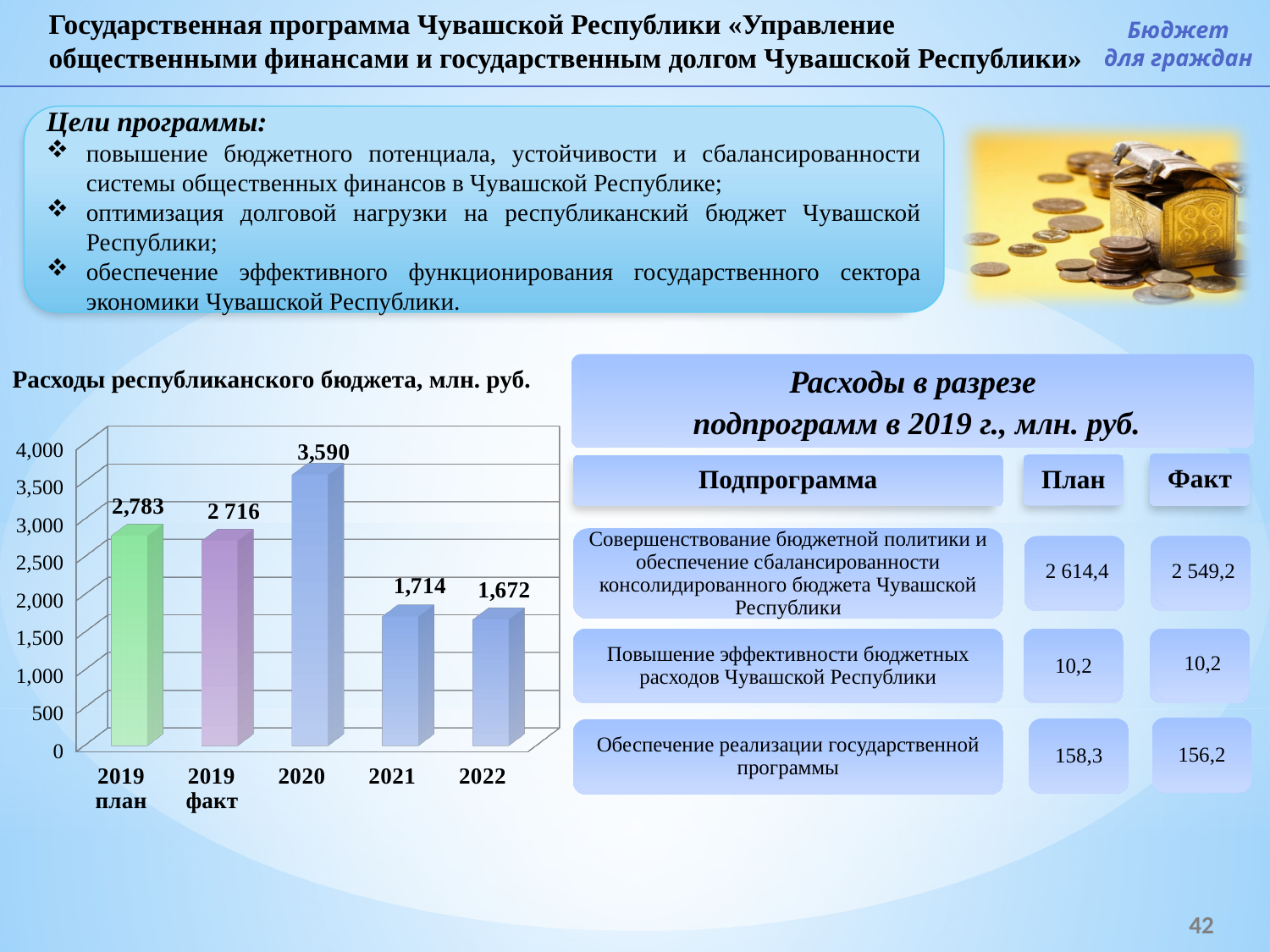
Which is larger, the value for 2019 план or 2019 факт? 2019 план What is the value for 2019 план in the chart? 2,783 What is the value for 2022 in the chart? 1,672 What is the difference between the values for 2019 план and 2019 факт? 67 Is the value for 2021 greater or less than 2,000? less What is the difference between the values for 2020 and 2021? 1,876 What kind of chart is shown on the slide? bar chart What is the value for 2020 in the chart 'Расходы республиканского бюджета, млн. руб.'? 3,590 How many bars are shown in the chart? 5 What is the value for 2019 факт in the chart? 2 716 Which category has the highest value in the chart? 2020 Which category has the lowest value in the chart? 2022